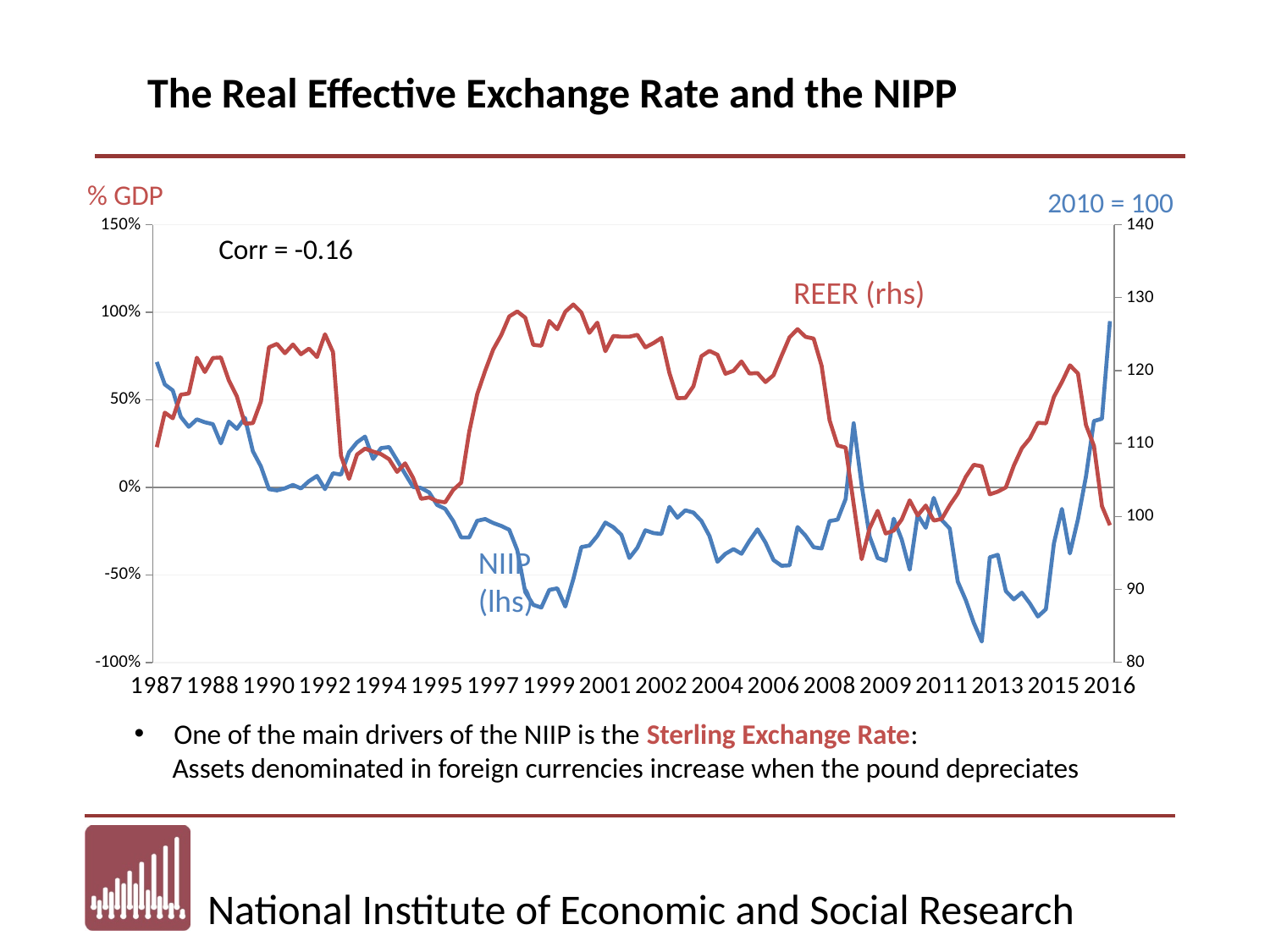
How many series are plotted on the chart? 2 What is the title of the chart on the slide? The Real Effective Exchange Rate and the NIPP Is the REER value at its low point around 2009 greater or less than 100? less Does the REER series rise or fall between 2007 and 2009? fall Is the peak value of the REER series around 1999 greater or less than 120? greater Is the NIIP value around 1999 greater or less than -50%? less Which series is plotted against the right-hand axis? REER What kind of chart is shown on the slide? line chart Does the NIIP series rise or fall between 2013 and 2016? rise What correlation value is printed on the chart? Corr = -0.16